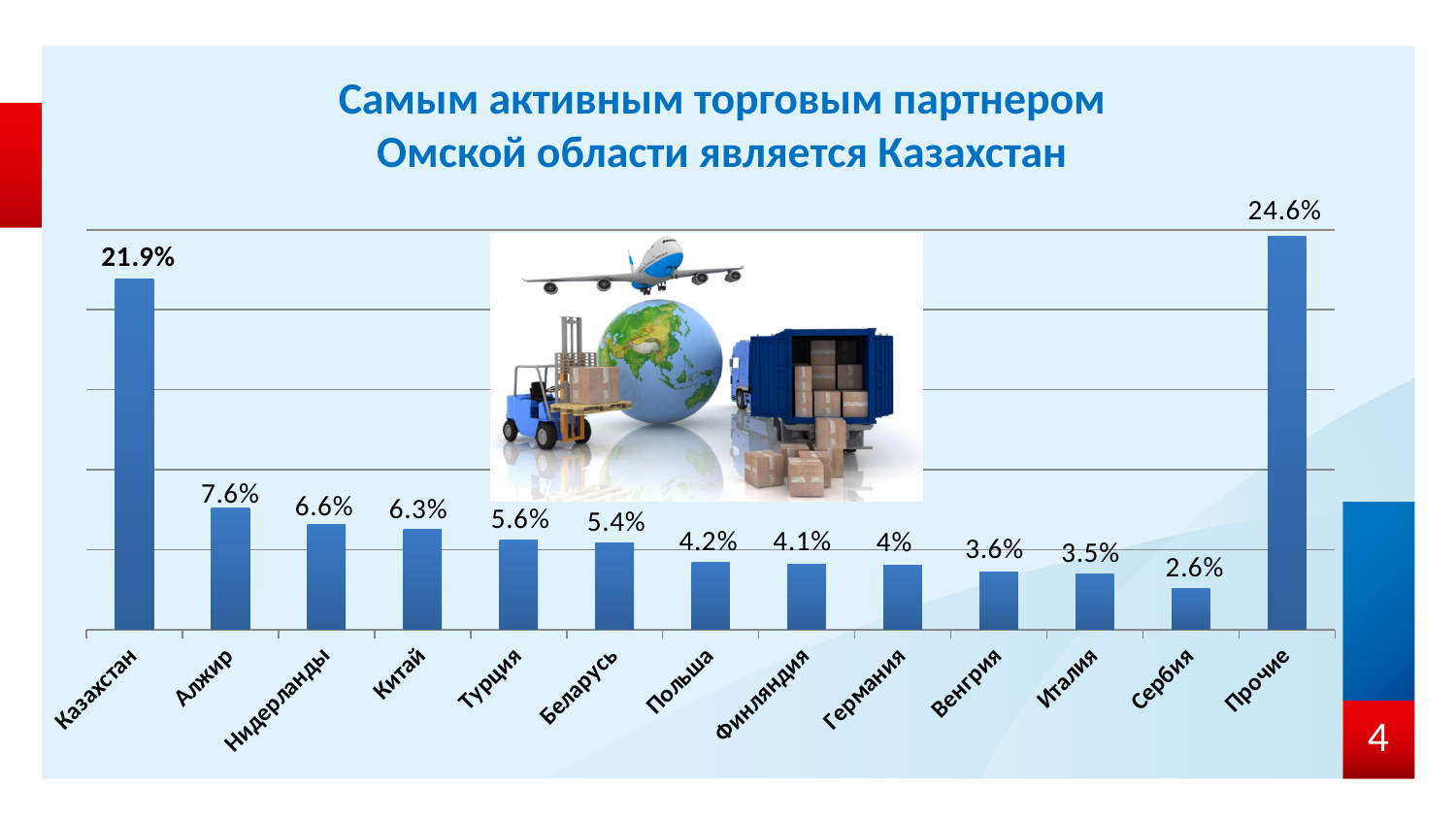
What is the value for Сербия? 2.6% Which category has the highest value? Прочие What is the value for Прочие? 24.6% What is the difference between the values for Алжир and Нидерланды? 1% What kind of chart is shown on the slide? bar chart What is the value for Казахстан? 21.9% Which category has the lowest value? Сербия Which is larger, the value for Турция or the value for Беларусь? Турция How many categories are shown on the x axis? 13 What is the difference between the values for Прочие and Казахстан? 2.7% What is the title of the slide? Самым активным торговым партнером Омской области является Казахстан What is the value for Германия? 4%